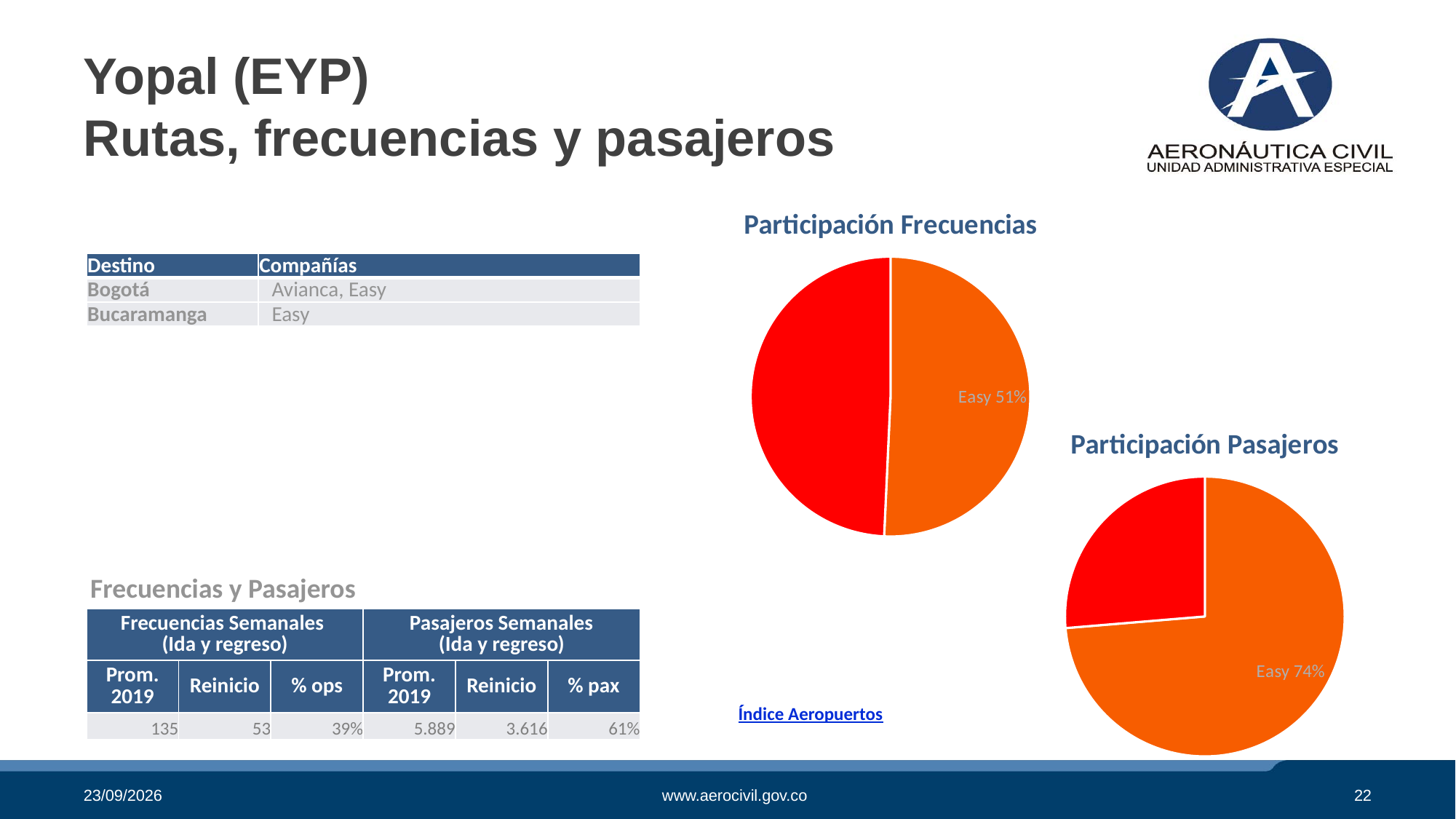
In the Participación Pasajeros chart, which slice is larger, the Easy slice or the other slice? Easy How many slices does the Participación Pasajeros pie have? 2 What kind of chart is Participación Frecuencias? Pie chart By how many percentage points is Easy's share in Participación Pasajeros higher than in Participación Frecuencias? 23 percentage points In which chart is Easy's share larger, Participación Frecuencias or Participación Pasajeros? Participación Pasajeros In the Participación Pasajeros chart, what share does Easy have? 74% In the Participación Pasajeros chart, what share of the pie is not Easy? 26% What kind of chart is Participación Pasajeros? Pie chart How many slices does the Participación Frecuencias pie have? 2 What colour is the Easy slice in the Participación Pasajeros chart? Orange What is the title of the upper pie chart on the slide? Participación Frecuencias In the Participación Frecuencias chart, what share does Easy have? 51%